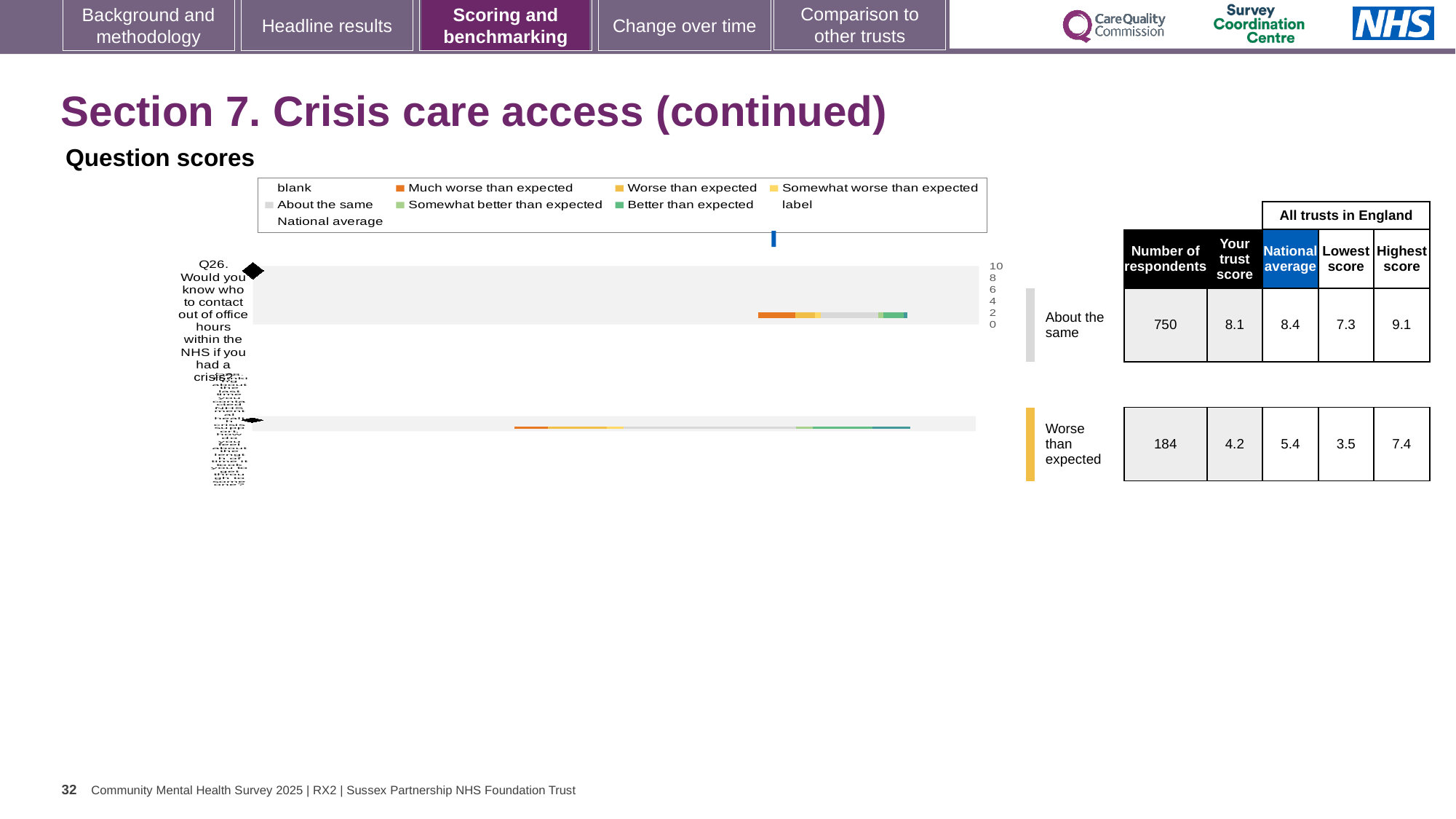
What is the highest score among all trusts in England for Q26? 9.1 What is the trust score for Q26 (Would you know who to contact out of office hours within the NHS if you had a crisis?)? 8.1 What kind of chart is used to show the question scores? Bar chart For Q26, what is the difference between the highest score and the lowest score among all trusts in England? 1.8 What is the lowest score among all trusts in England for Q26? 7.3 For the second question row (rated 'Worse than expected'), how much higher is the national average than the trust score? 1.2 What is the trust score for the second question row, the one rated 'Worse than expected'? 4.2 What benchmark rating is shown next to Q26? About the same How many respondents answered the second question row, the one rated 'Worse than expected'? 184 How many respondents answered Q26? 750 What is the national average score for Q26? 8.4 For Q26, which is larger: the trust score or the national average? National average